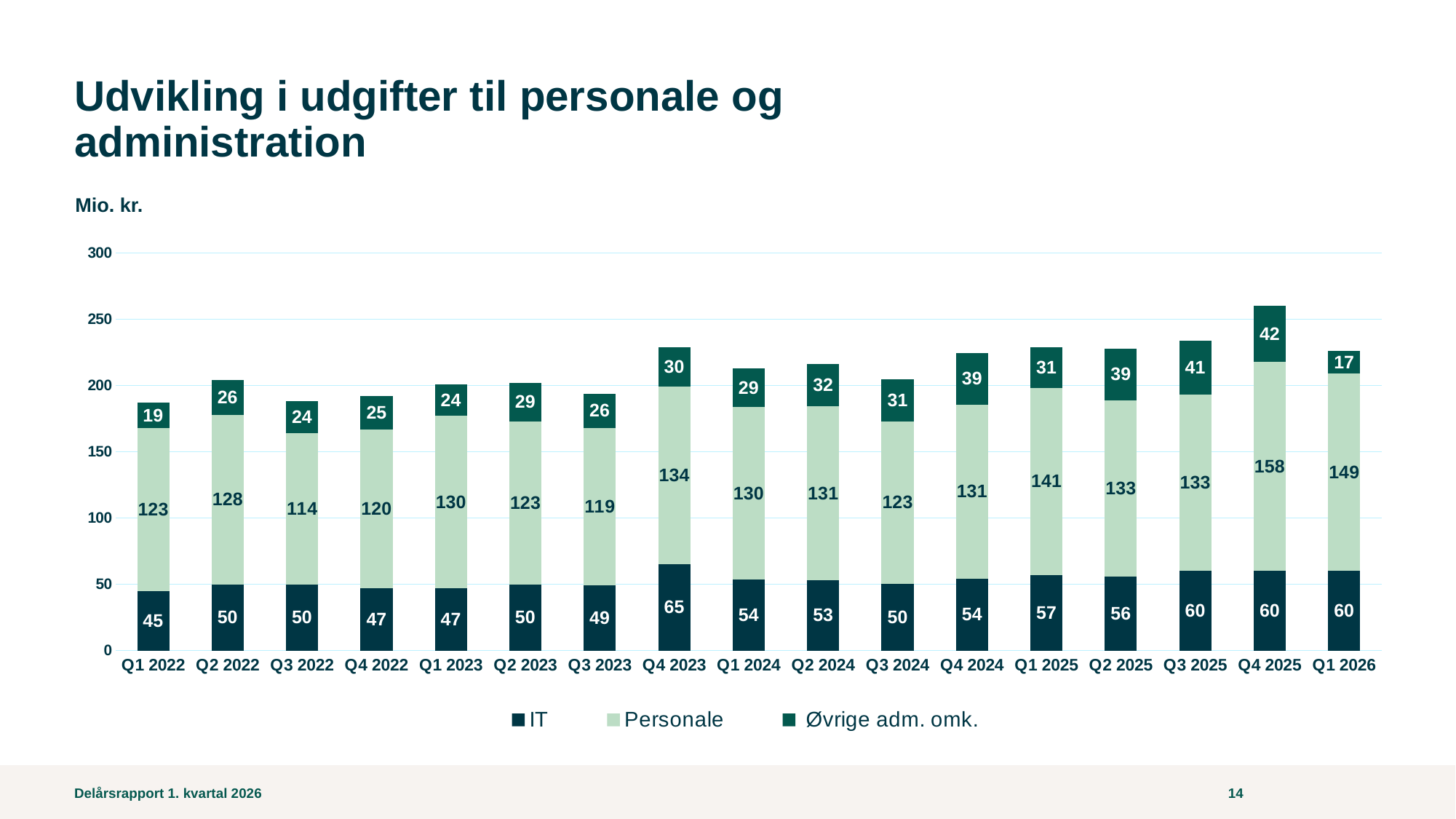
Which is larger, the Øvrige adm. omk. value for Q4 2024 or for Q1 2025? Q4 2024 What is the total of the stacked bar for Q4 2025? 260 In which quarter is the IT value lowest? Q1 2022 In which quarter is the Personale value lowest? Q3 2022 What is the Personale value for Q4 2025? 158 How many quarters are shown on the x axis? 17 What is the Øvrige adm. omk. value for Q1 2026? 17 In which quarter is the Personale value highest? Q4 2025 How many series does the legend list? 3 What is the difference between the Personale values for Q4 2025 and Q1 2026? 9 What is the IT value for Q4 2023? 65 What kind of chart is shown on the slide? Stacked bar chart